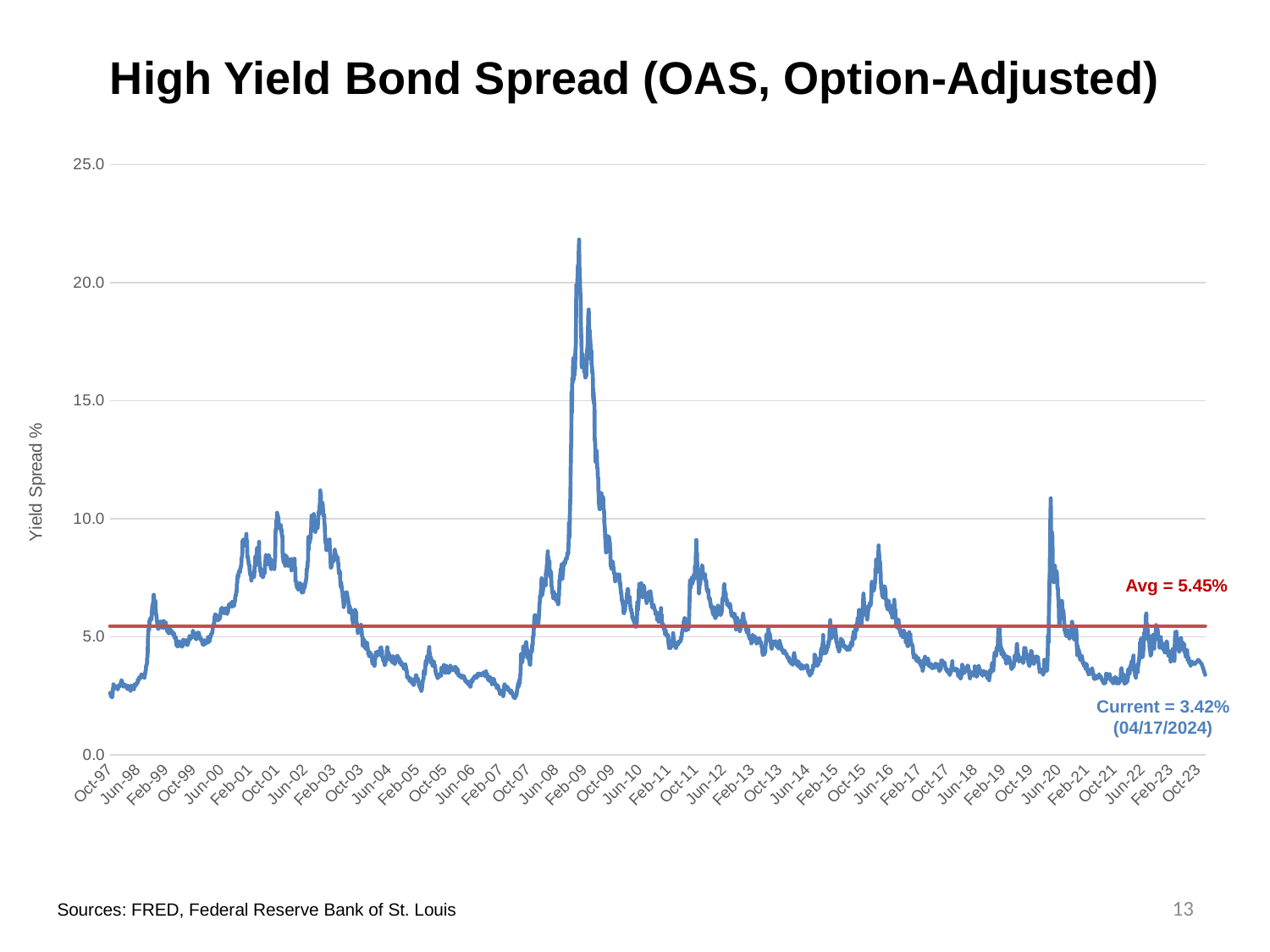
Is the peak spread around Feb-09 greater or less than 20.0? greater Is the spread at Oct-97 greater or less than 5.0? less Which is larger, the average spread or the current spread? the average spread What is the current high yield bond spread shown on the chart? 3.42% By how much is the average spread (5.45%) higher than the current spread (3.42%)? 2.03% Is the spread around Oct-01 greater or less than 5.0? greater What is the average high yield bond spread shown on the chart? 5.45% As of what date is the current spread value given? 04/17/2024 What kind of chart is shown on the slide? line chart Around which period does the spread reach its highest point? around Feb-09 What is the label on the vertical axis? Yield Spread % Does the spread rise or fall between Feb-09 and Jun-10? fall